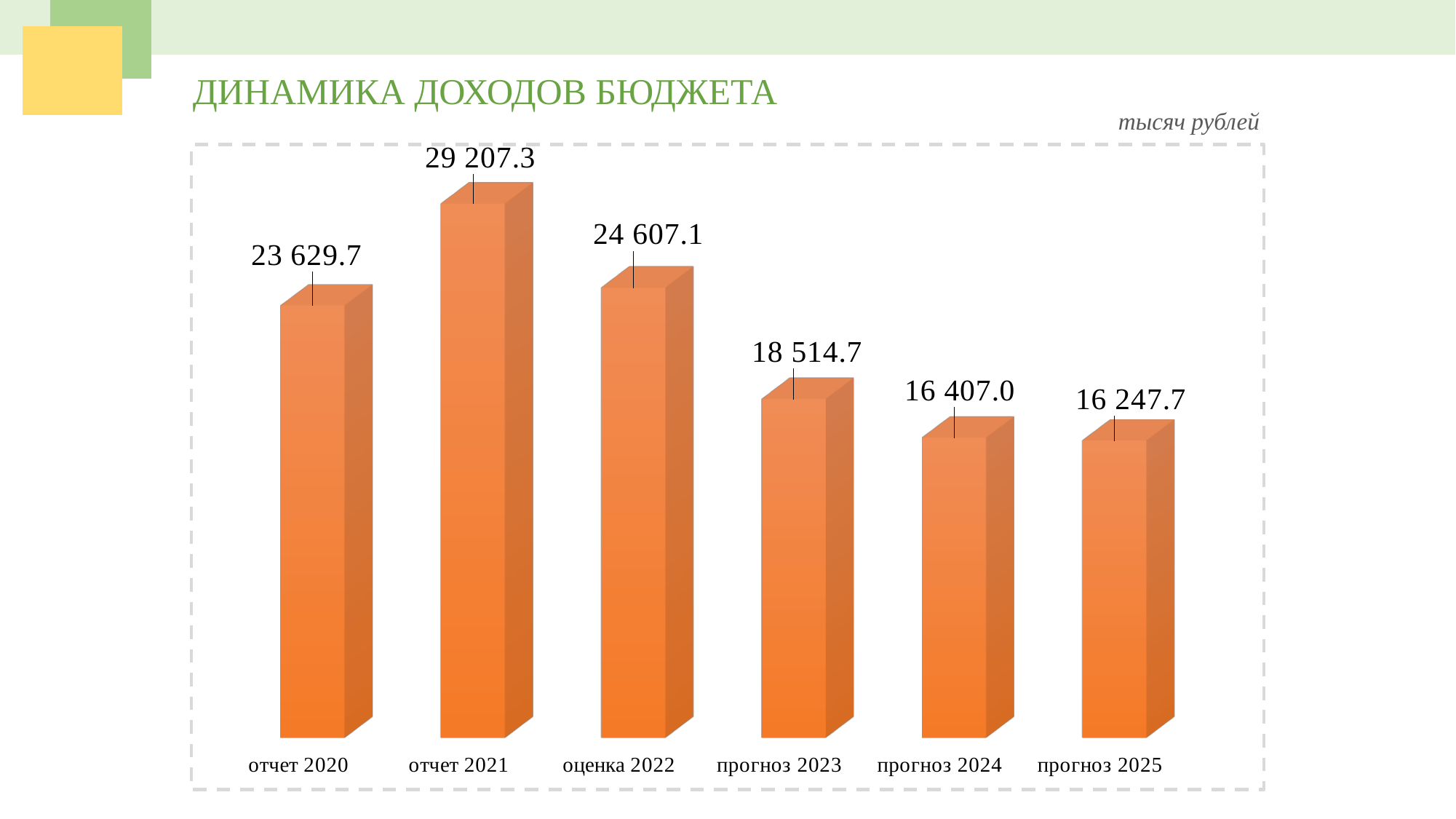
What is the difference between the values for прогноз 2024 and прогноз 2025? 159.3 Which category has the lowest value? прогноз 2025 Which category has the highest value? отчет 2021 How many categories are shown on the chart? 6 What is the value for отчет 2021? 29 207.3 What is the value for прогноз 2024? 16 407.0 Which is larger, the value for отчет 2020 or the value for оценка 2022? оценка 2022 What is the title of the chart? ДИНАМИКА ДОХОДОВ БЮДЖЕТА What is the difference between the values for отчет 2021 and отчет 2020? 5 577.6 What is the difference between the values for оценка 2022 and прогноз 2023? 6 092.4 What is the value for оценка 2022? 24 607.1 What kind of chart is shown on the slide? bar chart